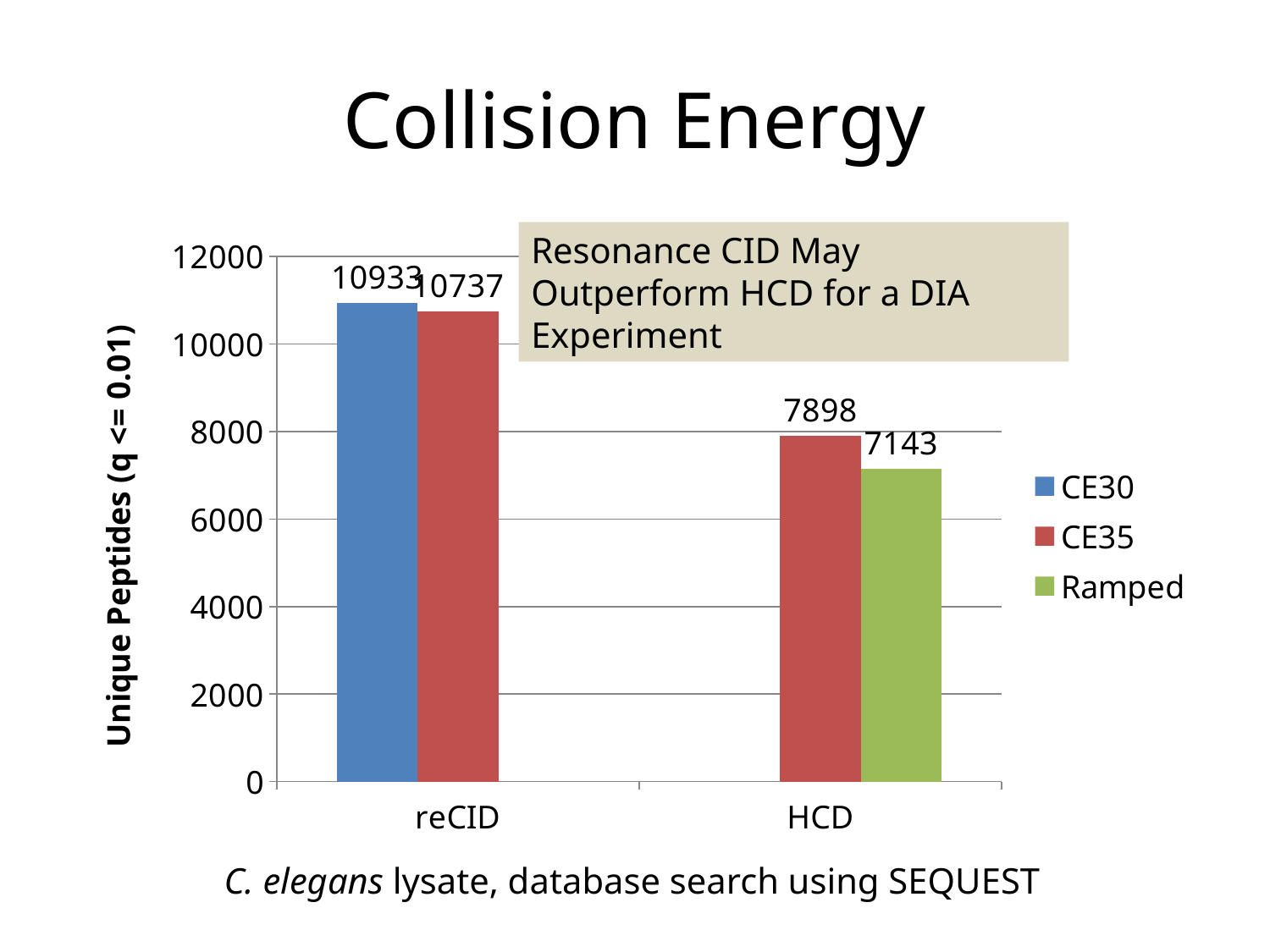
What is the difference between the CE35 and Ramped values in the HCD category? 755 What is the value for CE35 in the HCD category? 7898 What kind of chart is shown on the slide? Bar chart What is the value for CE35 in the reCID category? 10737 Which is larger, the CE30 value for reCID or the CE35 value for reCID? CE30 value for reCID Which bar has the highest value on the chart? CE30 in reCID What is the value for CE30 in the reCID category? 10933 How many series does the legend list? 3 What is the difference between the CE35 values for reCID and HCD? 2839 Which bar has the lowest value on the chart? Ramped in HCD What is the label of the y axis? Unique Peptides (q <= 0.01) What is the value for Ramped in the HCD category? 7143